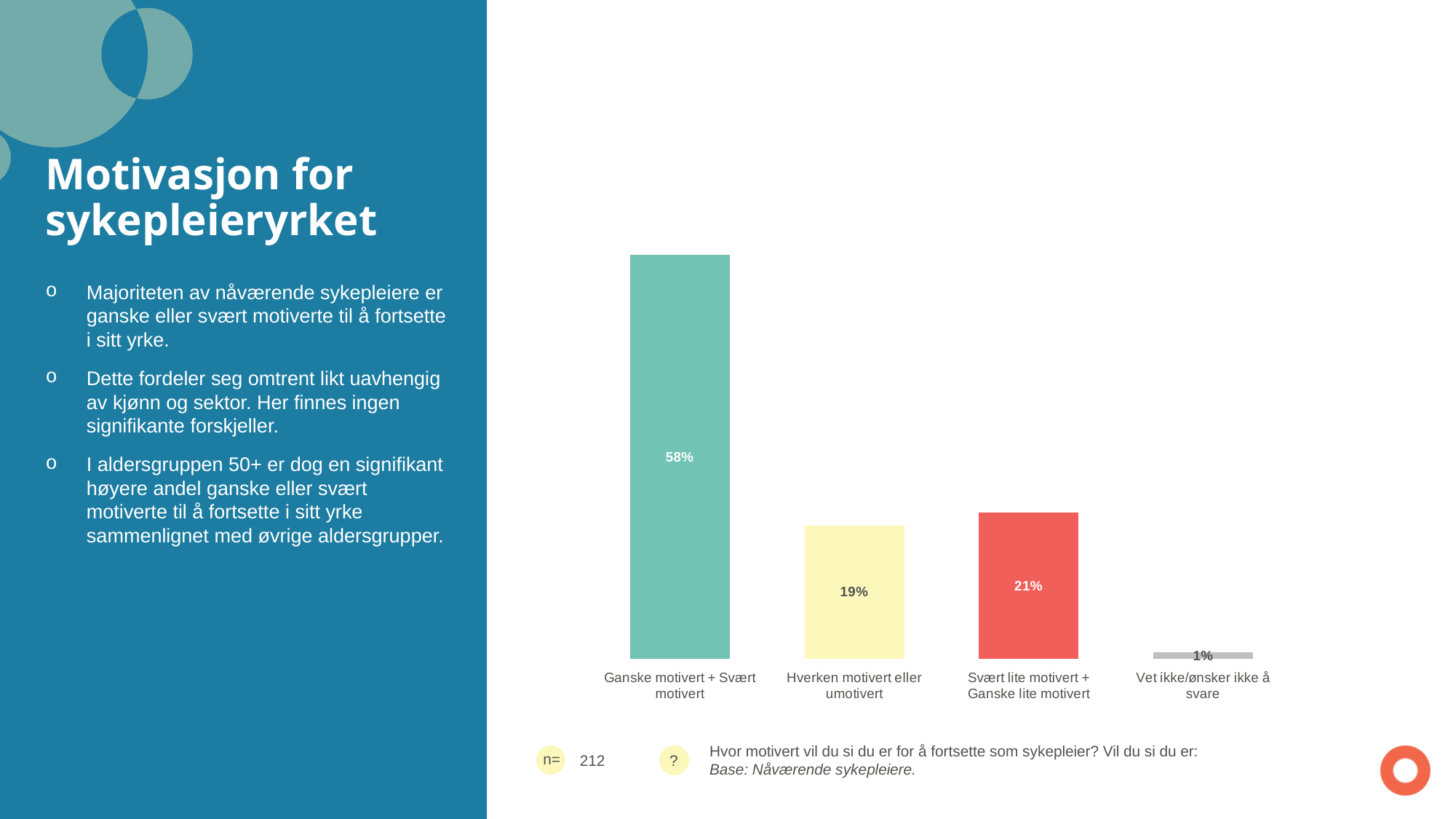
How many categories are shown in the chart? 4 What is the value for "Svært lite motivert + Ganske lite motivert"? 21% Which category has the highest value? Ganske motivert + Svært motivert What is the sample size (n) shown below the chart? 212 What kind of chart is shown on the slide? Bar chart What is the value for "Hverken motivert eller umotivert"? 19% What is the value for "Ganske motivert + Svært motivert"? 58% What is the value for "Vet ikke/ønsker ikke å svare"? 1% Which category has the lowest value? Vet ikke/ønsker ikke å svare What is the difference between "Svært lite motivert + Ganske lite motivert" and "Hverken motivert eller umotivert"? 2% What is the difference between "Ganske motivert + Svært motivert" and "Svært lite motivert + Ganske lite motivert"? 37% Which is larger, "Hverken motivert eller umotivert" or "Svært lite motivert + Ganske lite motivert"? Svært lite motivert + Ganske lite motivert